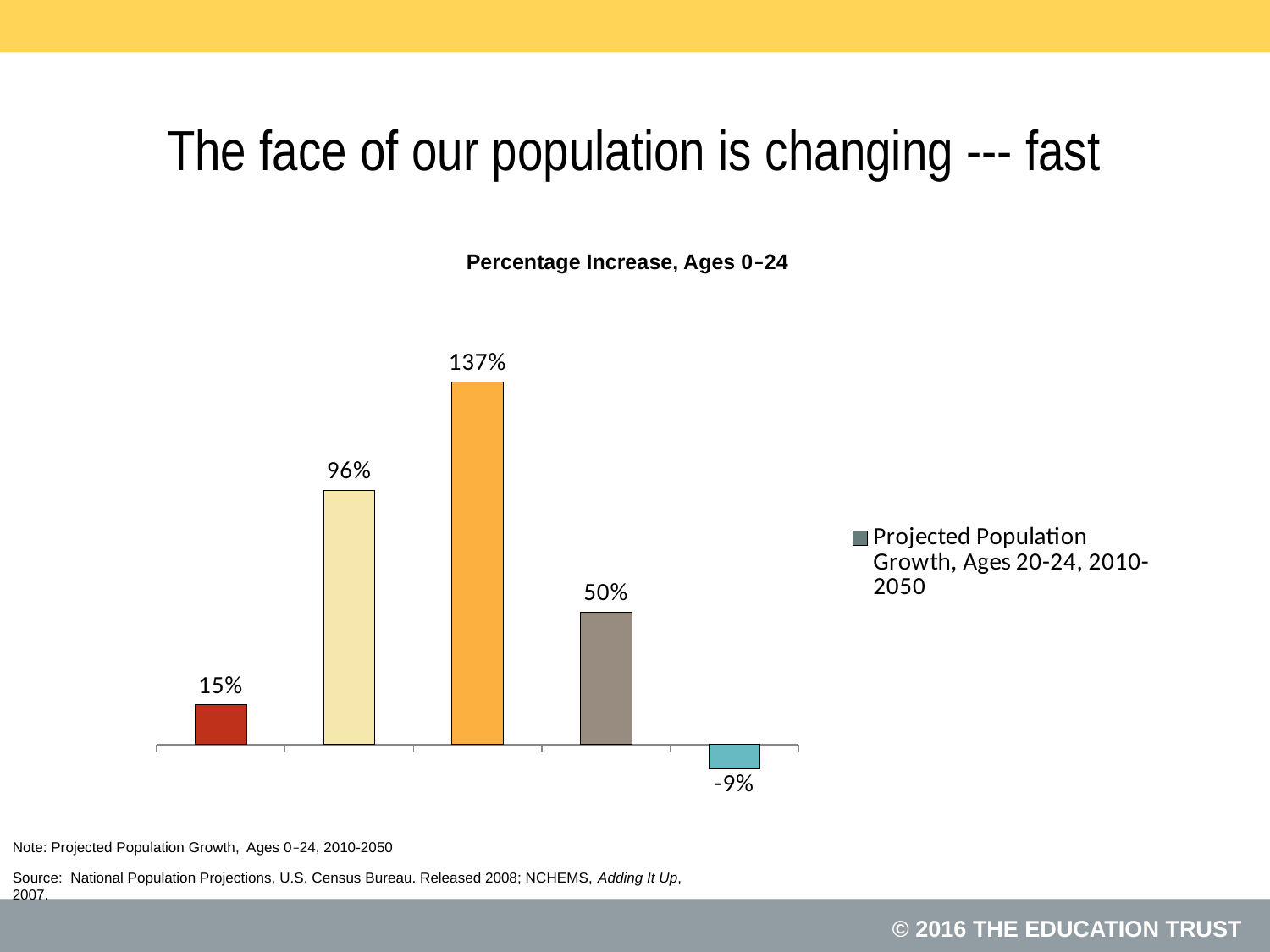
What value is shown on the second (pale yellow) bar? 96% What is the title of the chart? Percentage Increase, Ages 0–24 What value is shown on the fourth (grey) bar? 50% What is the difference between the third bar (137%) and the second bar (96%)? 41% What is the highest value shown in the chart? 137% What series name does the legend show? Projected Population Growth, Ages 20-24, 2010-2050 What value is shown on the first (leftmost, red) bar? 15% How many bars are plotted in the chart? 5 What is the lowest value shown in the chart? -9% How many series does the legend list? 1 What kind of chart is shown on the slide? bar chart Which is larger, the value of the fourth (grey) bar or the first (red) bar? the fourth (grey) bar